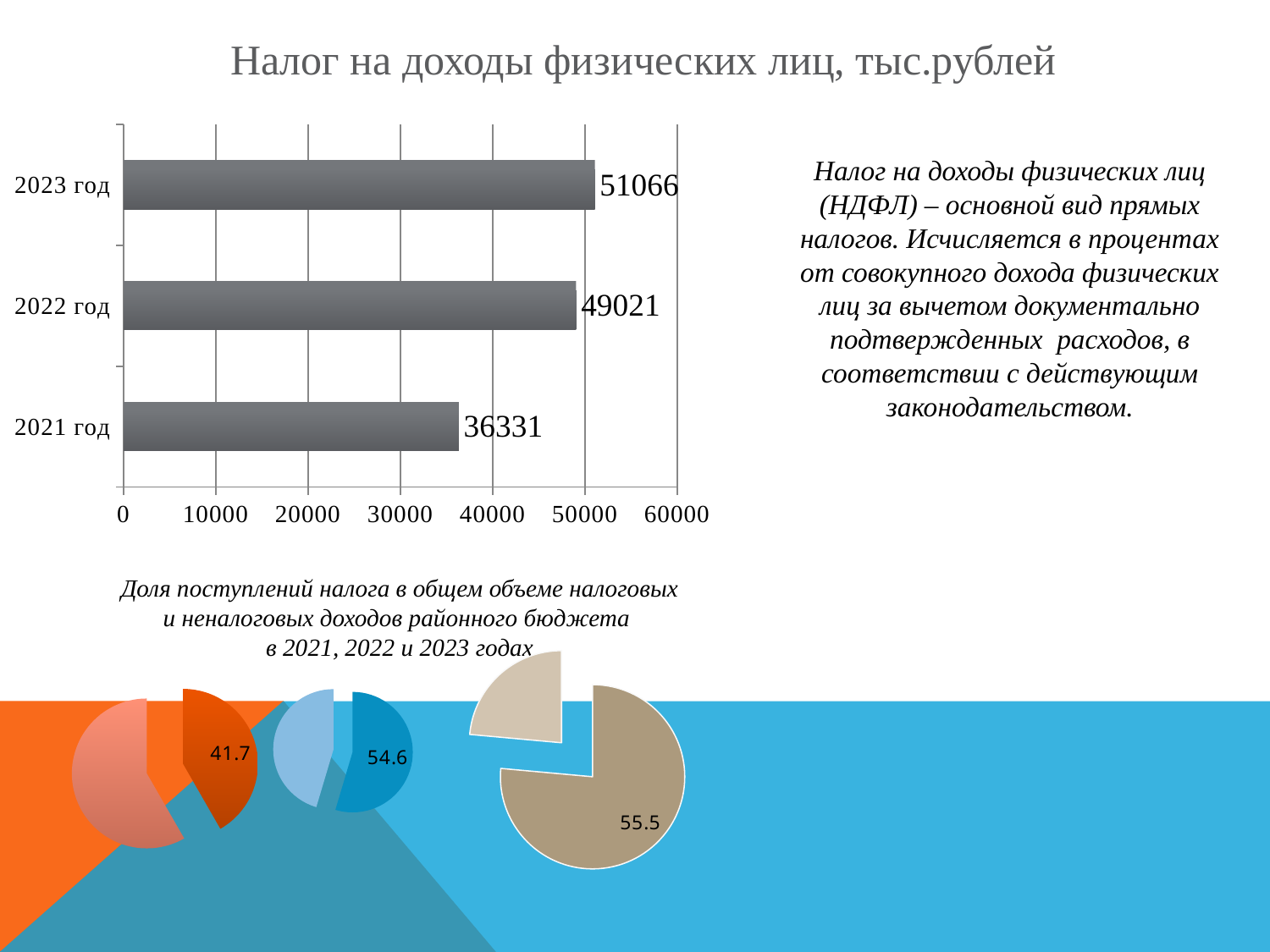
On the bar chart, which is larger: the value for 2022 год or 2021 год? 2022 год On the bar chart, what is the value for 2023 год? 51066 On the bar chart, which year has the lowest value? 2021 год On the bar chart, how many years are shown? 3 On the bar chart, which year has the highest value? 2023 год On the bar chart, what is the difference between the values for 2023 год and 2021 год? 14735 On the pie charts at the bottom of the slide, what value is labelled on the rightmost pie? 55.5 On the bar chart, what is the value for 2021 год? 36331 On the bar chart, what is the value for 2022 год? 49021 On the bar chart, what is the difference between the values for 2022 год and 2021 год? 12690 What kind of chart is the chart at the top left of the slide? bar chart On the bar chart, do the values rise or fall from 2021 год to 2023 год? rise